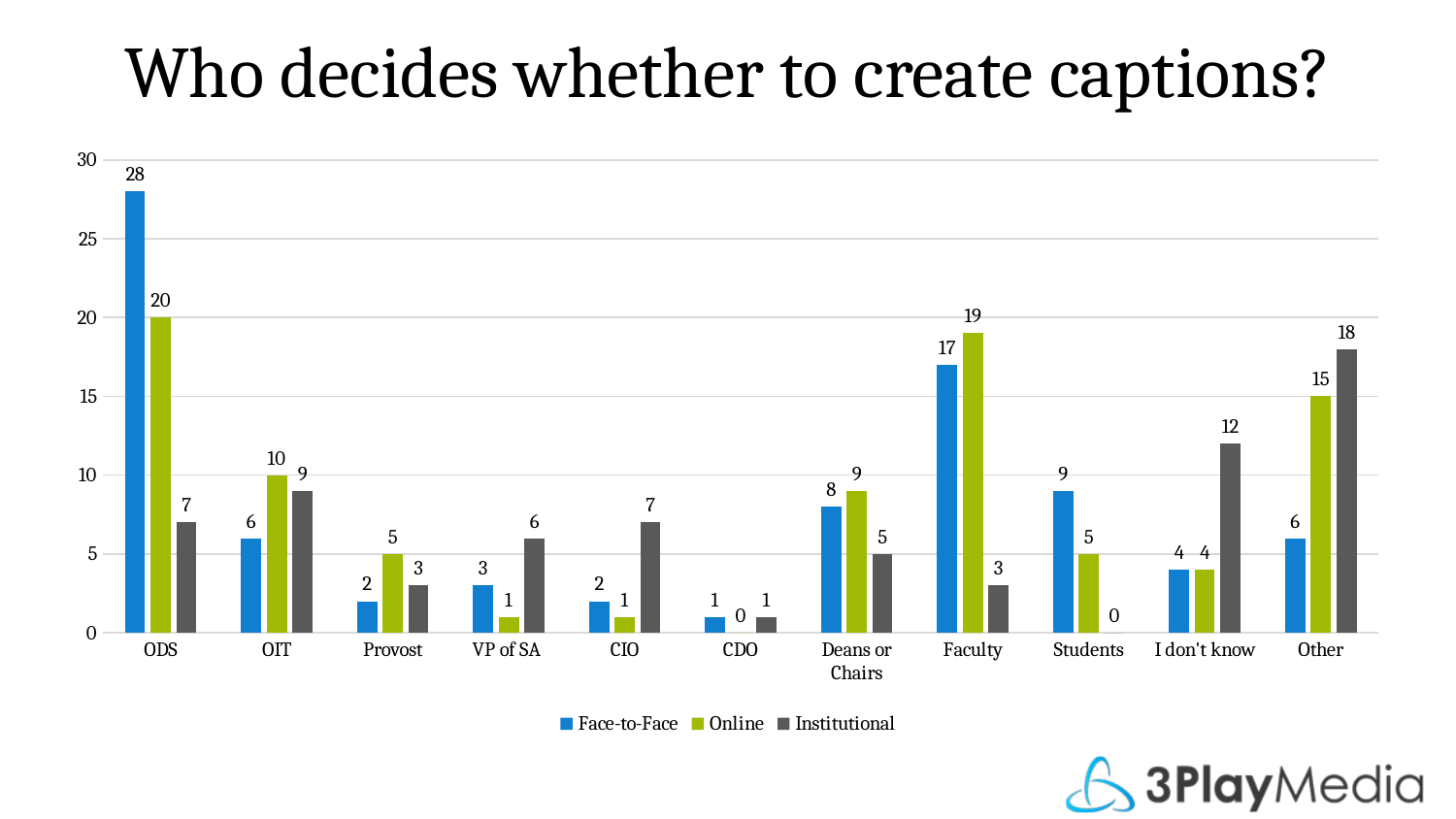
What kind of chart is shown on the slide? Bar chart Which category has the highest Institutional value? Other What is the title of the chart? Who decides whether to create captions? What is the Institutional value for I don't know? 12 What is the Face-to-Face value for ODS? 28 Which is larger for Students: the Face-to-Face value or the Online value? Face-to-Face What is the Online value for Faculty? 19 What is the difference between the Face-to-Face and Online values for ODS? 8 How many categories are shown on the x axis? 11 Which category has the lowest Online value? CDO How many series does the legend list? 3 What is the total of the three values for Other? 39